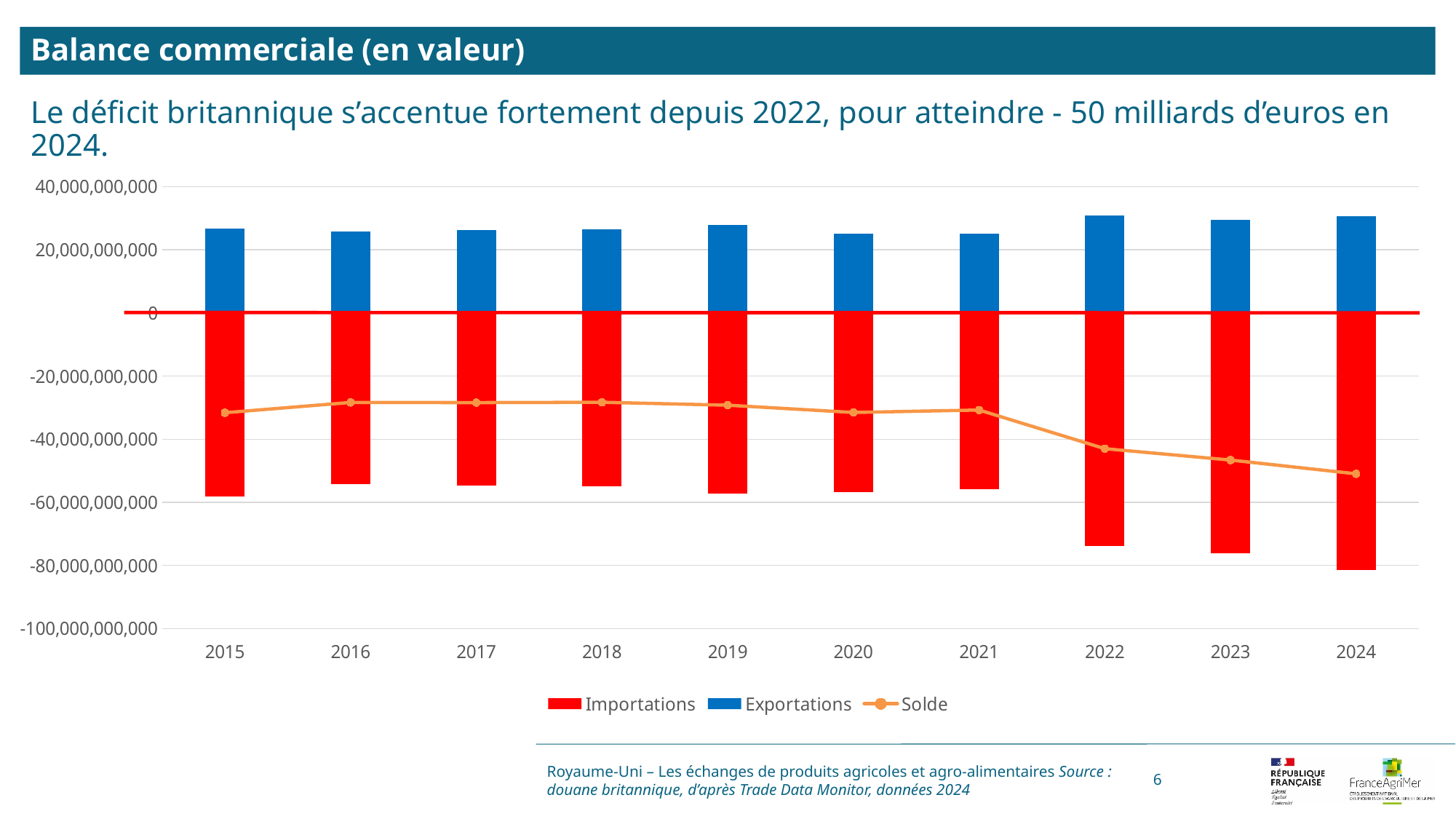
What colour are the Importations bars in the chart? Red What kind of chart is shown on the slide? A bar chart with a line series Is the Exportations value for 2015 greater or less than 20,000,000,000? greater How many years are shown on the x axis of the chart? 10 Which year has the lowest point on the Solde line? 2024 Which year has the lowest (most negative) Importations bar? 2024 Is the Solde value for 2022 greater or less than -40,000,000,000? less Is the Importations value for 2024 greater or less than -60,000,000,000? less Does the Solde line rise or fall between 2021 and 2024? Falls How many series does the chart legend list? 3 Which year has the higher Solde value, 2021 or 2023? 2021